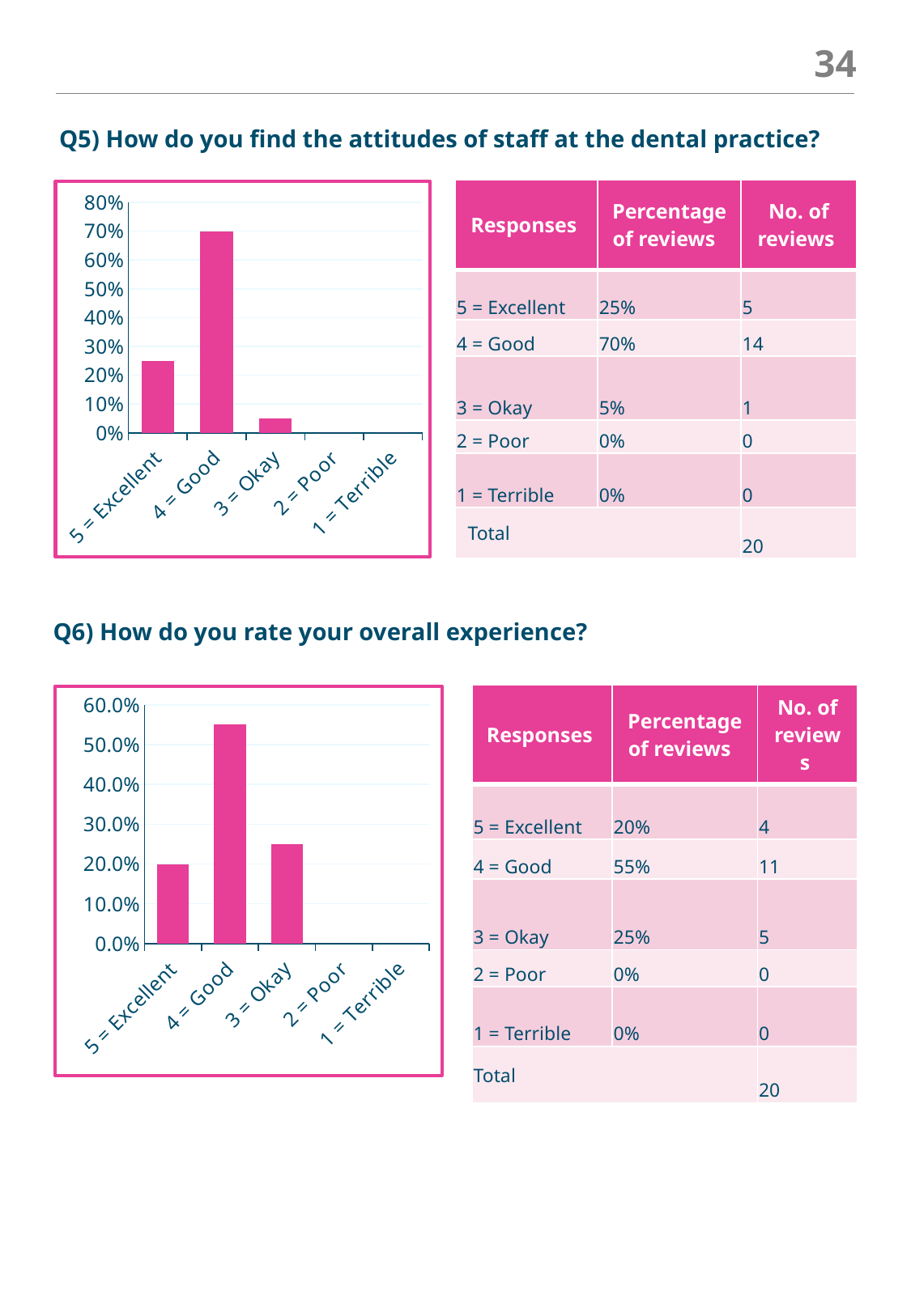
In the Q5 chart (attitudes of staff), how many response categories are shown on the x axis? 5 In the Q6 chart (overall experience), is the value for 4 = Good greater or less than 50.0%? greater What type of chart is used for Q5 (attitudes of staff)? Bar chart In the Q6 chart (overall experience), what is the highest value shown on the y axis? 60.0% In the Q6 chart (overall experience), which response category has the highest percentage of reviews? 4 = Good In the Q5 chart (attitudes of staff), what percentage of reviews rated the staff as 4 = Good? 70% In the Q5 chart (attitudes of staff), what is the difference in percentage points between 4 = Good and 5 = Excellent? 45% In the Q6 chart (overall experience), what percentage of reviews rated the experience as 3 = Okay? 25% In the Q6 chart (overall experience), what is the difference in percentage points between 4 = Good and 3 = Okay? 30% In the Q5 chart (attitudes of staff), is the value for 5 = Excellent greater or less than 20%? greater In the Q5 chart (attitudes of staff), which response category has the highest percentage of reviews? 4 = Good In the Q6 chart (overall experience), which is larger: the value for 5 = Excellent or the value for 3 = Okay? 3 = Okay